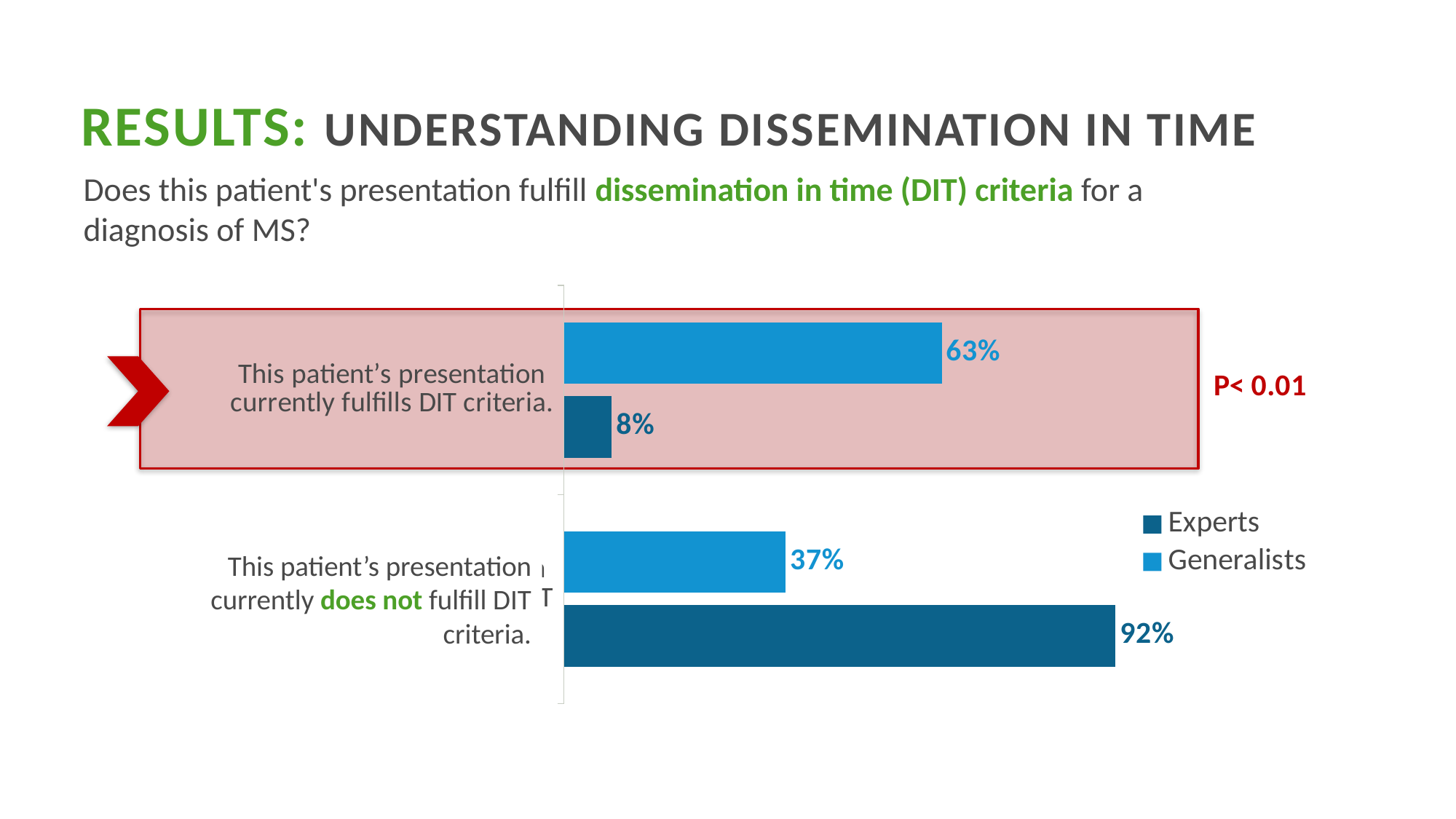
What is the difference between the Experts and Generalists values for 'does not fulfill DIT criteria'? 55 percentage points What percentage of Generalists said the patient's presentation currently does not fulfill DIT criteria? 37% For 'currently fulfills DIT criteria', which group has the larger value, Experts or Generalists? Generalists What percentage of Generalists said the patient's presentation currently fulfills DIT criteria? 63% What is the difference between the Generalists and Experts values for 'currently fulfills DIT criteria'? 55 percentage points What kind of chart is shown on the slide? Bar chart How many series does the legend list? 2 What percentage of Experts said the patient's presentation currently does not fulfill DIT criteria? 92% What percentage of Experts said the patient's presentation currently fulfills DIT criteria? 8% Which bar has the lowest value on the chart? Experts, currently fulfills DIT criteria (8%) Which group has the highest value on the chart, and for which response? Experts, does not fulfill DIT criteria (92%) What p-value is shown next to the highlighted 'currently fulfills DIT criteria' bars? P< 0.01